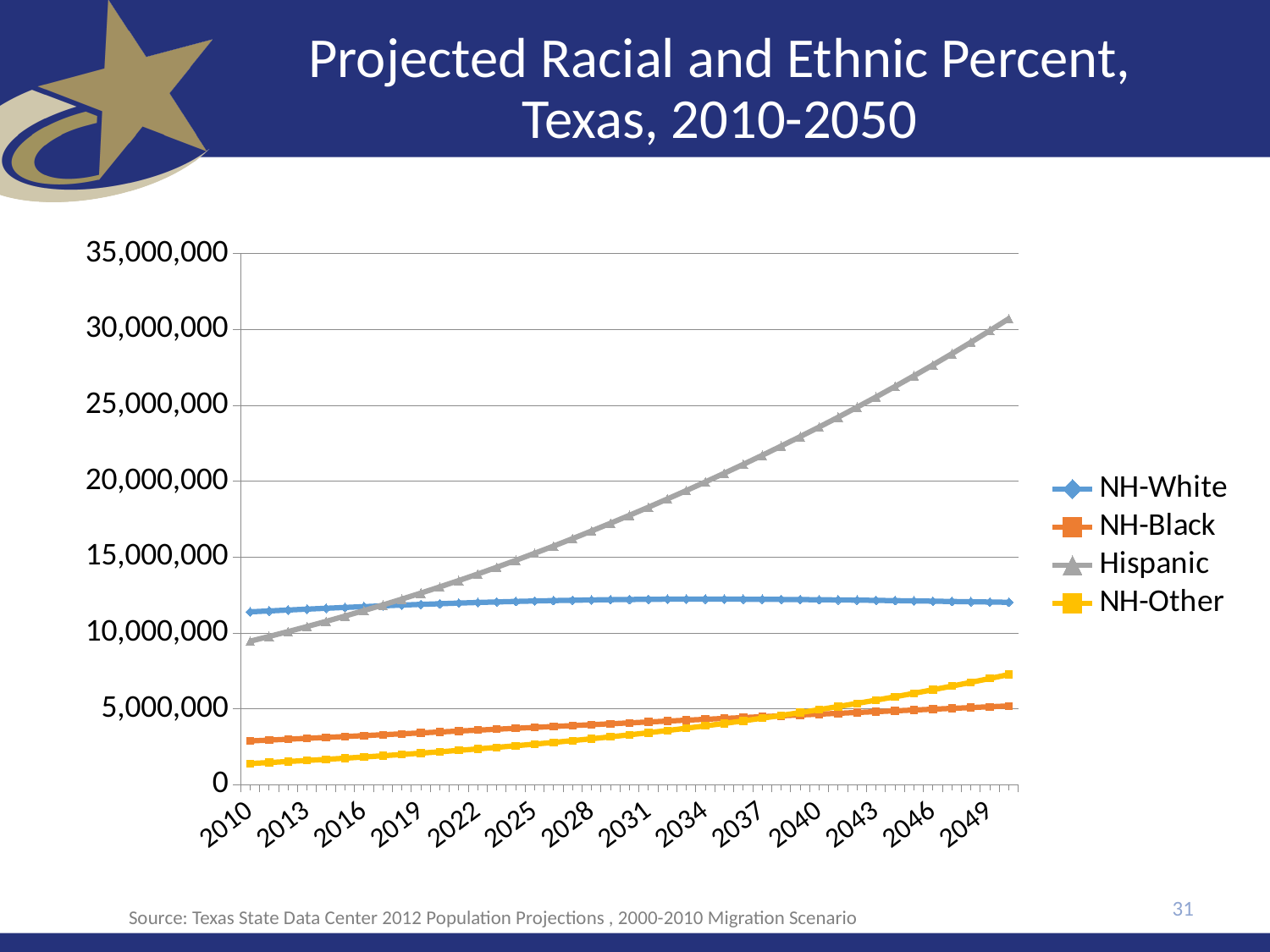
What is the title of the chart? Projected Racial and Ethnic Percent, Texas, 2010-2050 Is the value for Hispanic in 2049 greater or less than 25,000,000? greater What kind of chart is shown on the slide? line chart Which series has the lowest value in 2010? NH-Other Which series has the highest value in 2049? Hispanic Is the value for NH-Black in 2010 greater or less than 5,000,000? less In 2049, which is larger, NH-Other or NH-Black? NH-Other Is the value for NH-White in 2010 greater or less than 10,000,000? greater Which series has the lowest value in 2049? NH-Black How many series does the legend list? 4 Which series has the highest value in 2010? NH-White Does the Hispanic series rise or fall from 2010 to 2049? rise